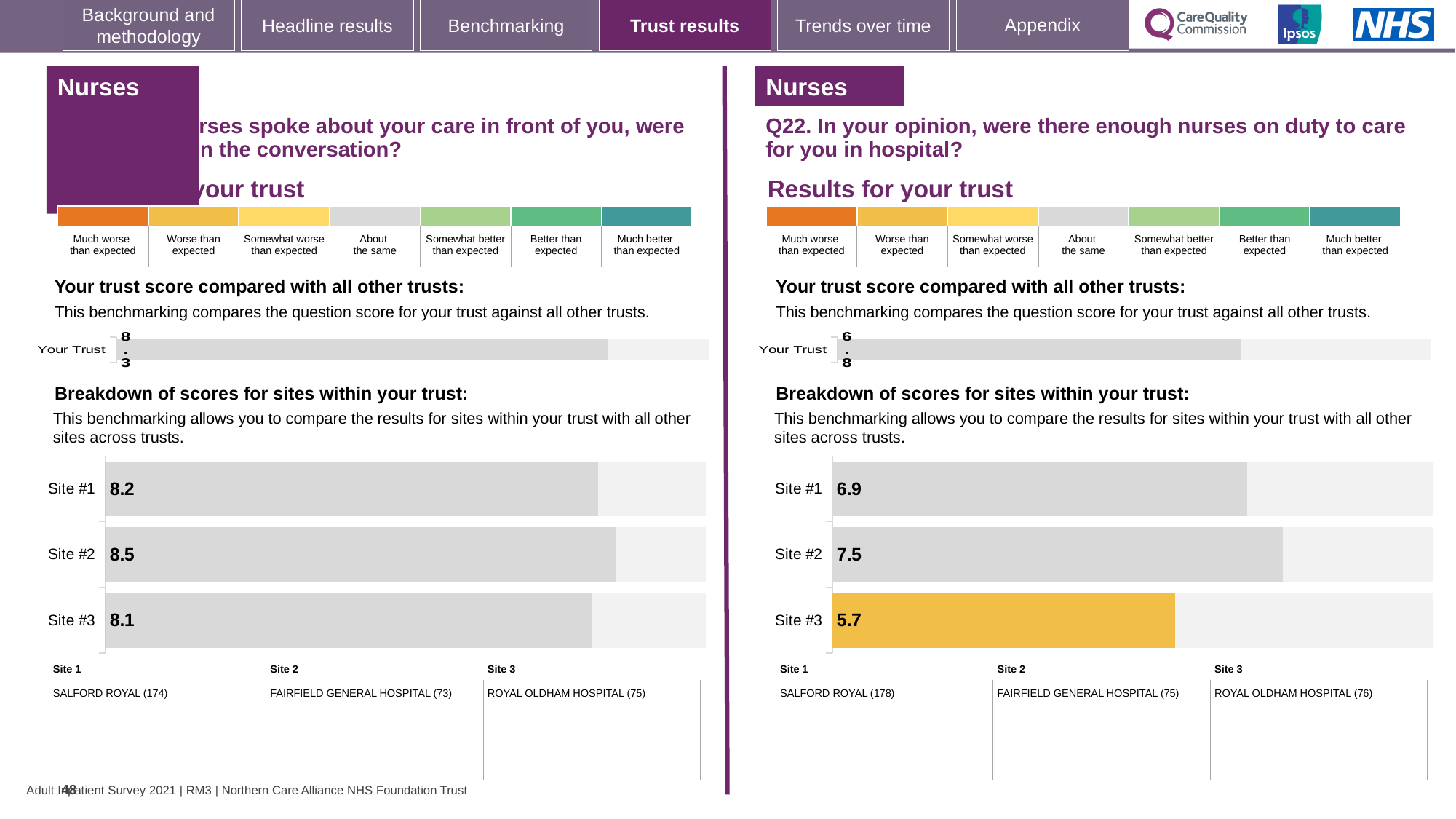
On the right-hand slide half (Q22), what is the 'Your Trust' score shown in the trust score chart? 6.8 On the left-hand slide half, which site has the highest score in the breakdown of scores for sites chart? Site #2 On the right-hand slide half (Q22), which site has a higher score in the breakdown chart, Site #1 or Site #2? Site #2 On the right-hand slide half (Q22), what is the difference between the Site #2 and Site #3 scores in the breakdown chart? 1.8 On the left-hand slide half, what is the difference between the Site #2 and Site #3 scores in the breakdown chart? 0.4 What type of chart is used for the breakdown of scores for sites on the left-hand slide half? Bar chart On the right-hand slide half (Q22), which site's bar in the breakdown chart is coloured yellow rather than grey? Site #3 On the right-hand slide half (Q22), which site has the lowest score in the breakdown of scores for sites chart? Site #3 How many sites are shown in the breakdown of scores for sites chart on the right-hand slide half (Q22)? 3 On the left-hand slide half, what is the 'Your Trust' score shown in the trust score chart? 8.3 On the left-hand slide half, what is the score for Site #1 in the breakdown of scores for sites chart? 8.2 On the right-hand slide half (Q22), what is the score for Site #2 in the breakdown of scores for sites chart? 7.5